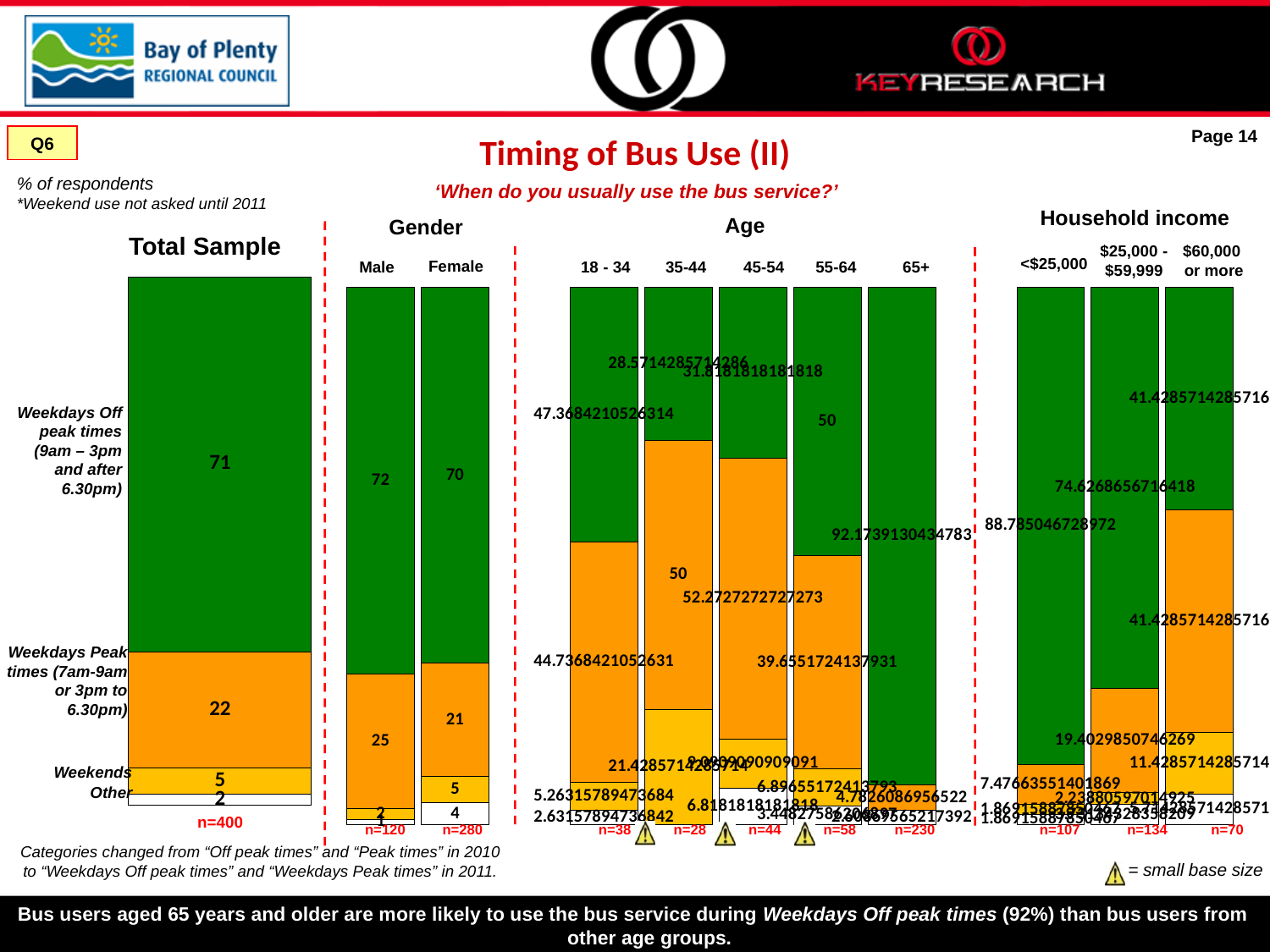
In the Total Sample chart, what is the value for Weekdays Peak times? 22 In the Total Sample chart, what is the value for Weekends? 5 In the Total Sample chart, what is the difference between the Weekdays Off peak times and Weekdays Peak times values? 49 What type of chart is used on this slide? Stacked bar chart In the Gender chart, what is the Weekdays Peak times value for Female respondents? 21 In the Gender chart, what is the Weekdays Off peak times value for Male respondents? 72 In the Gender chart, which gender has the larger Weekends value, Male or Female? Female In the Gender chart, what is the difference between the Male and Female values for Weekdays Peak times? 4 What is the sample size (n) shown for the Total Sample bar? n=400 In the Total Sample chart, which category has the lowest value? Other In the Total Sample chart, what percentage of respondents use the bus during Weekdays Off peak times? 71 How many age groups are shown in the Age chart? 5